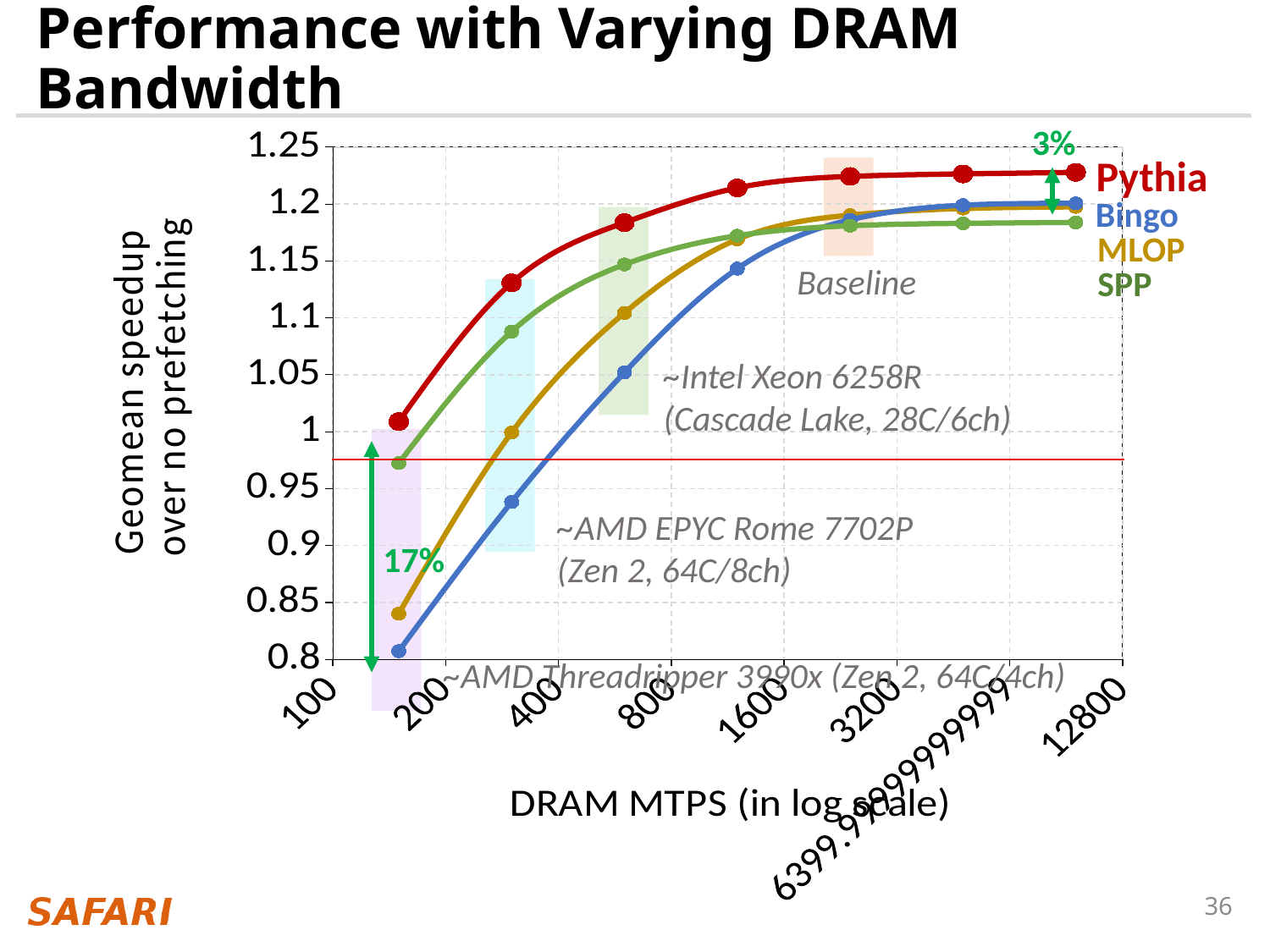
Which series has the lowest geomean speedup at the left end of the chart? Bingo Which series has the highest geomean speedup at the right end of the chart (12800 DRAM MTPS)? Pythia How many series (prefetchers) are plotted on the chart? 4 Do the geomean speedup values rise or fall as DRAM MTPS increases? rise What percentage is annotated with the green arrow at the left side of the chart? 17% Around 400 DRAM MTPS, which series is lower, Bingo or MLOP? Bingo Is the value for SPP at the rightmost point greater or less than 1.2? less Is the value for Pythia at the rightmost point greater or less than 1.2? greater Around 400 DRAM MTPS, which series is higher, Pythia or Bingo? Pythia Is the value for Bingo at the leftmost point greater or less than 0.85? less What is the title of the x axis? DRAM MTPS (in log scale) What kind of chart is shown on the slide? line chart